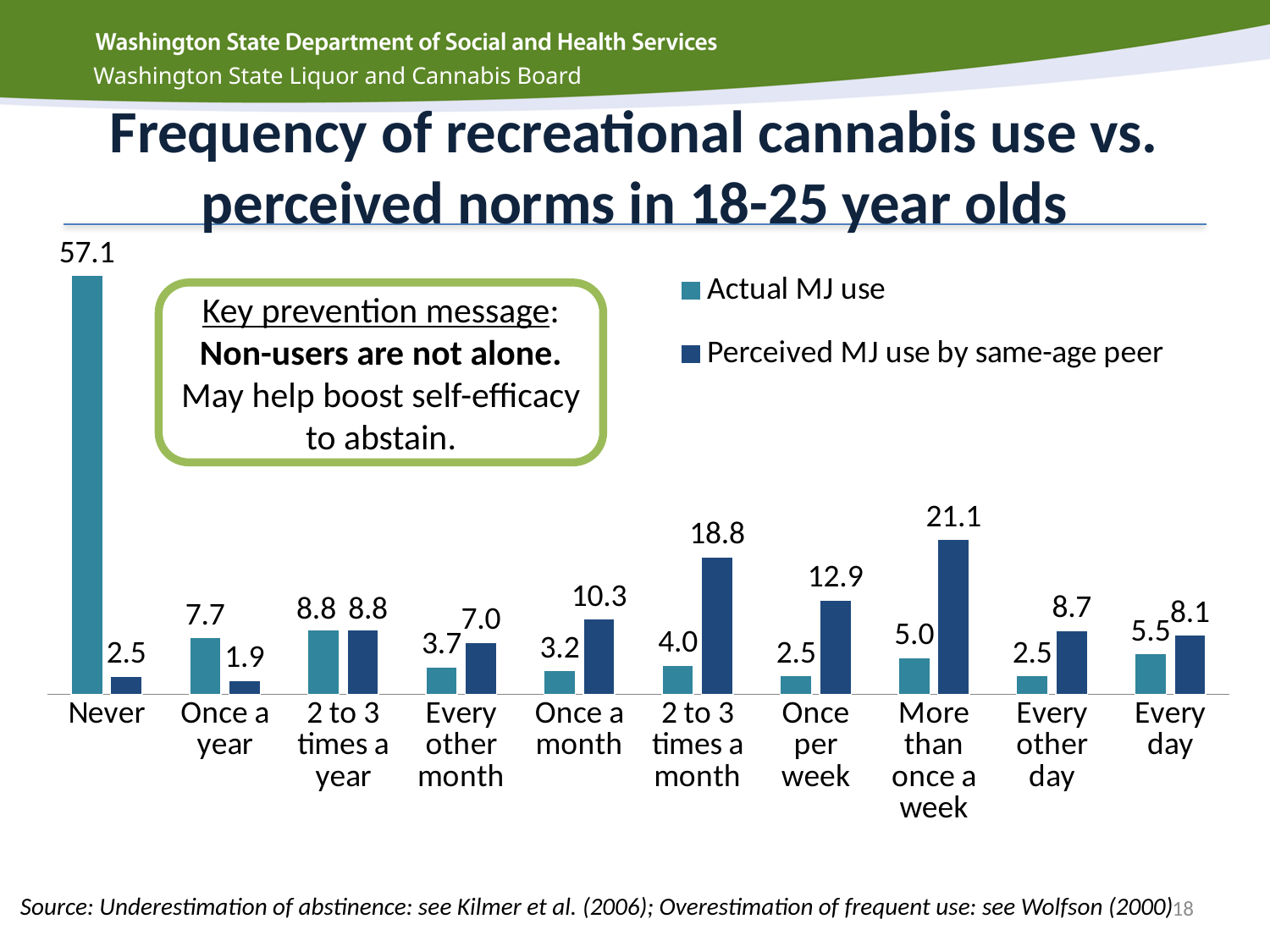
What is the Actual MJ use value for the Never category? 57.1 What is the Actual MJ use value for the Every day category? 5.5 What kind of chart is shown on the slide? Bar chart How many categories are shown on the x axis of the chart? 10 How many series does the chart's legend list? 2 What is the Perceived MJ use by same-age peer value for the More than once a week category? 21.1 For the Once per week category, which is larger: Actual MJ use or Perceived MJ use by same-age peer? Perceived MJ use by same-age peer What is the difference between the Perceived MJ use by same-age peer value and the Actual MJ use value for the 2 to 3 times a month category? 14.8 What is the title of the chart on the slide? Frequency of recreational cannabis use vs. perceived norms in 18-25 year olds Which category has the highest Perceived MJ use by same-age peer value? More than once a week Which category has the lowest Perceived MJ use by same-age peer value? Once a year What is the Perceived MJ use by same-age peer value for the Once a month category? 10.3